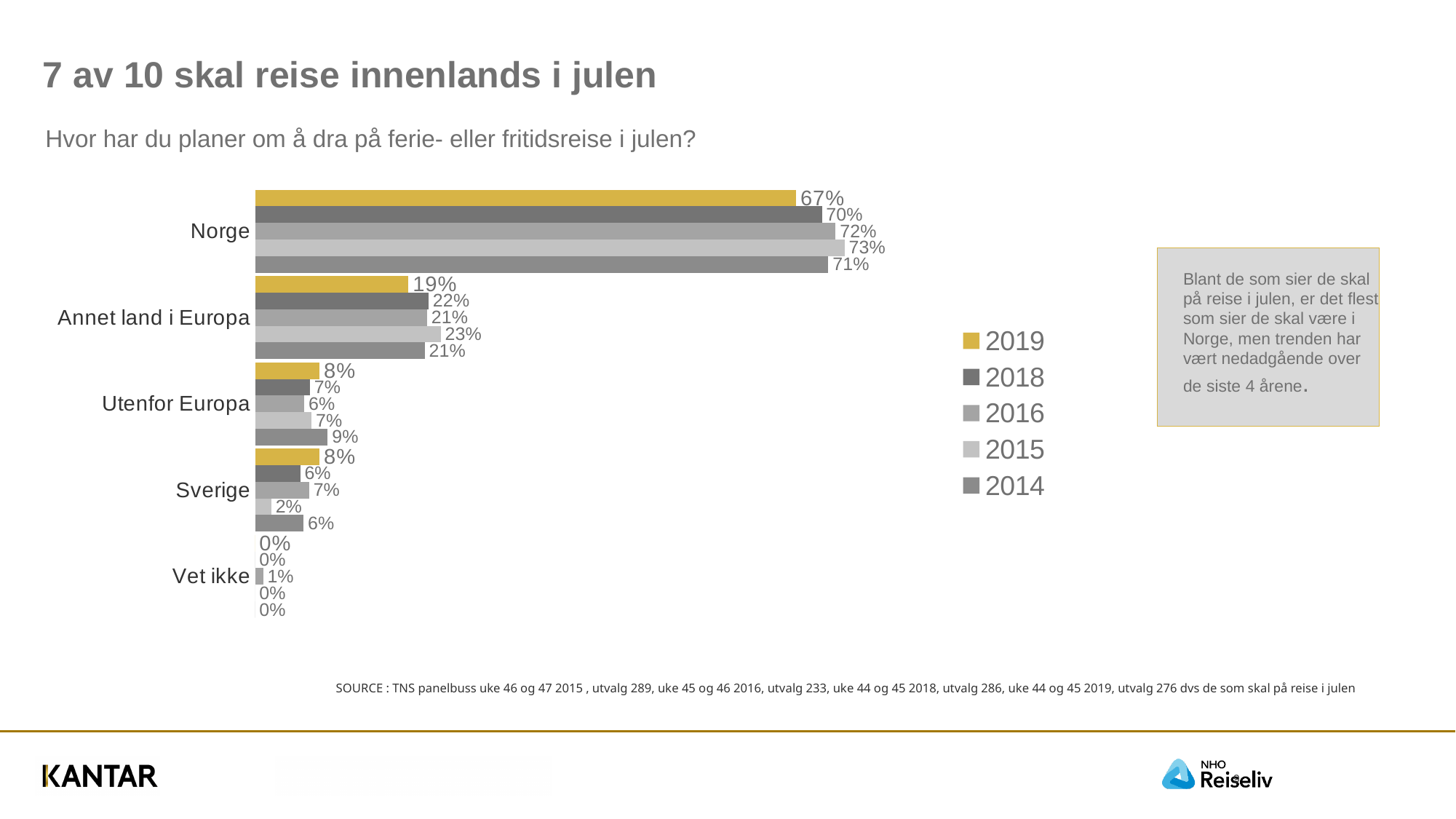
How many categories are shown on the chart? 5 What is the difference between the 2015 and 2019 values for Norge? 6% How many series does the legend list? 5 Which category has the highest value in 2019? Norge What is the value for Norge in 2019? 67% Which is larger for Utenfor Europa: the 2014 value or the 2019 value? 2014 What is the value for Sverige in 2015? 2% Which series is shown in yellow in the legend? 2019 What is the value for Vet ikke in 2016? 1% What kind of chart is shown on the slide? bar chart Which year has the lowest value for Norge? 2019 What is the value for Annet land i Europa in 2015? 23%